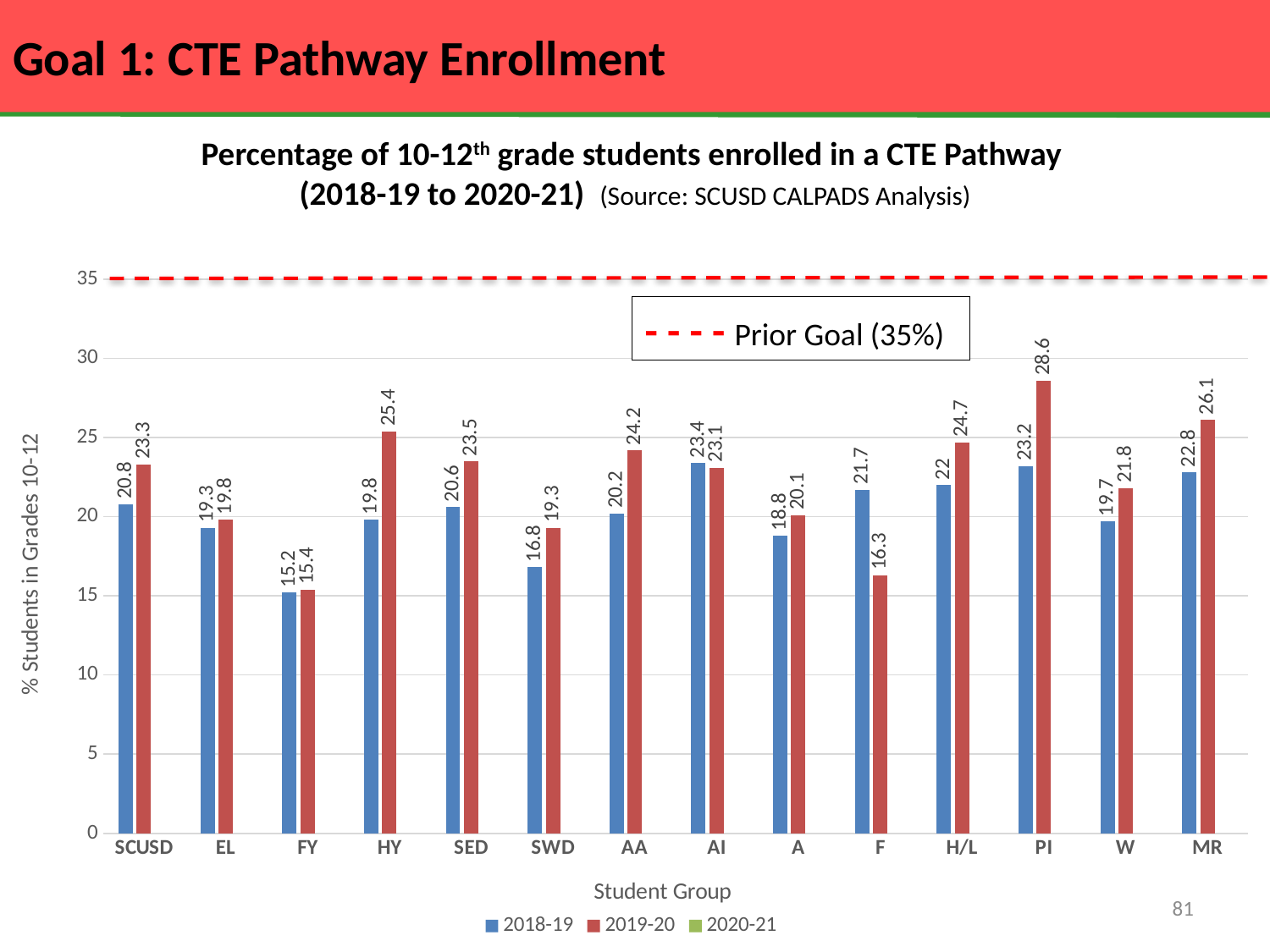
What kind of chart is shown on the slide? Bar chart Which student group has the lowest 2018-19 value? FY What is the 2019-20 value for PI? 28.6 How many student groups are shown on the x axis? 14 How many series does the legend list? 3 What is the difference between the 2019-20 and 2018-19 values for HY? 5.6 Which student group has the highest 2019-20 value? PI Is the 2019-20 value for MR greater or less than 25? greater What value does the red dashed line labelled Prior Goal represent? 35% What is the 2019-20 value for F? 16.3 Which is larger for F, the 2018-19 value or the 2019-20 value? 2018-19 What is the 2018-19 value for SWD? 16.8